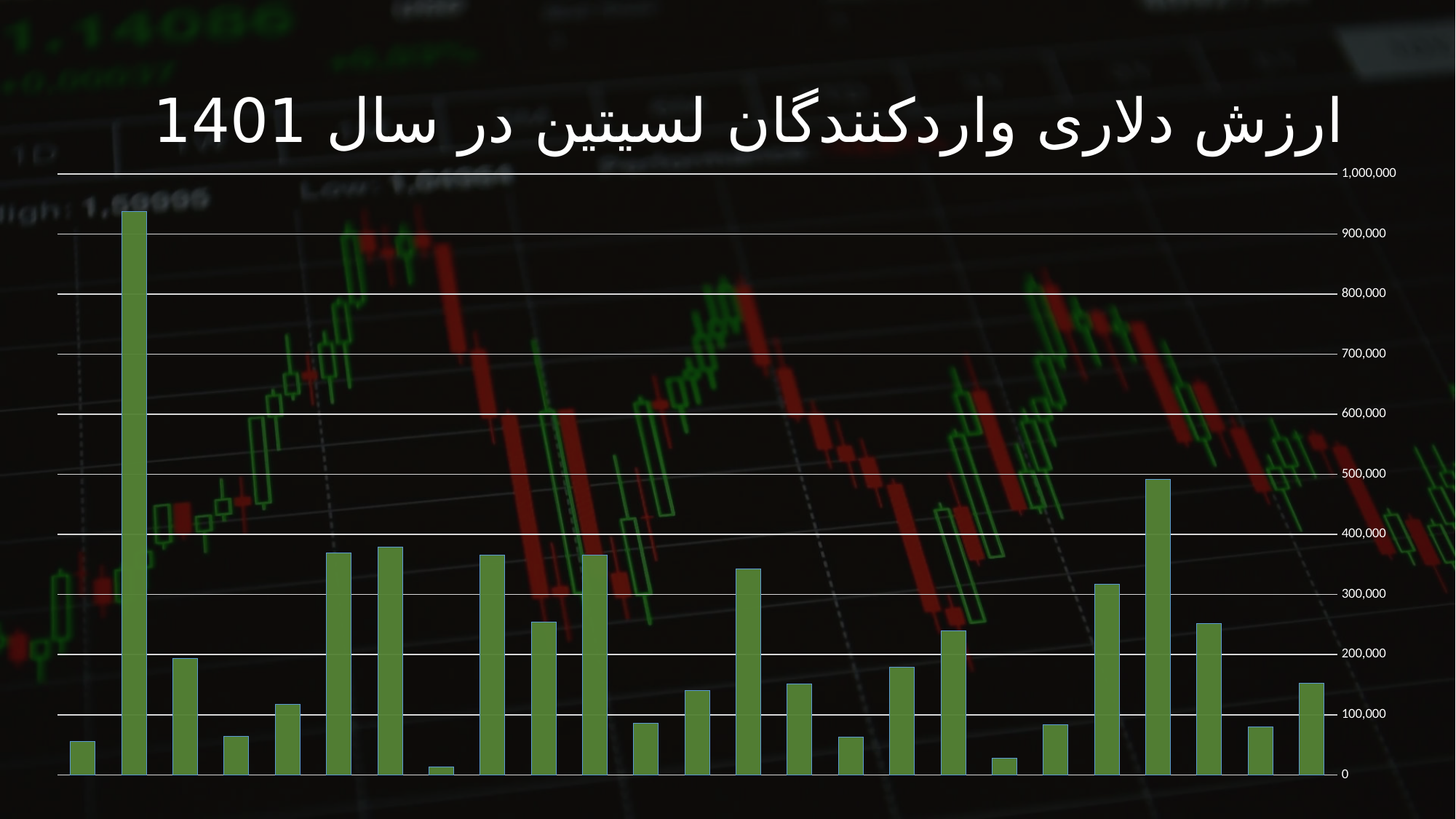
What kind of chart is shown on the slide? bar chart Which bar is the tallest in the chart? the second bar from the left What is the title of the chart? ارزش دلاری واردکنندگان لسیتین در سال 1401 Is the value of the fourth bar from the right greater or less than 400,000? greater Is the value of the seventh bar from the left greater or less than 300,000? greater Is the value of the last bar on the right greater or less than 200,000? less Which bar is the shortest in the chart? the eighth bar from the left What is the highest value shown on the vertical axis? 1,000,000 Which is larger: the second bar from the left or the fourth bar from the right? the second bar from the left How many bars are plotted in the chart? 25